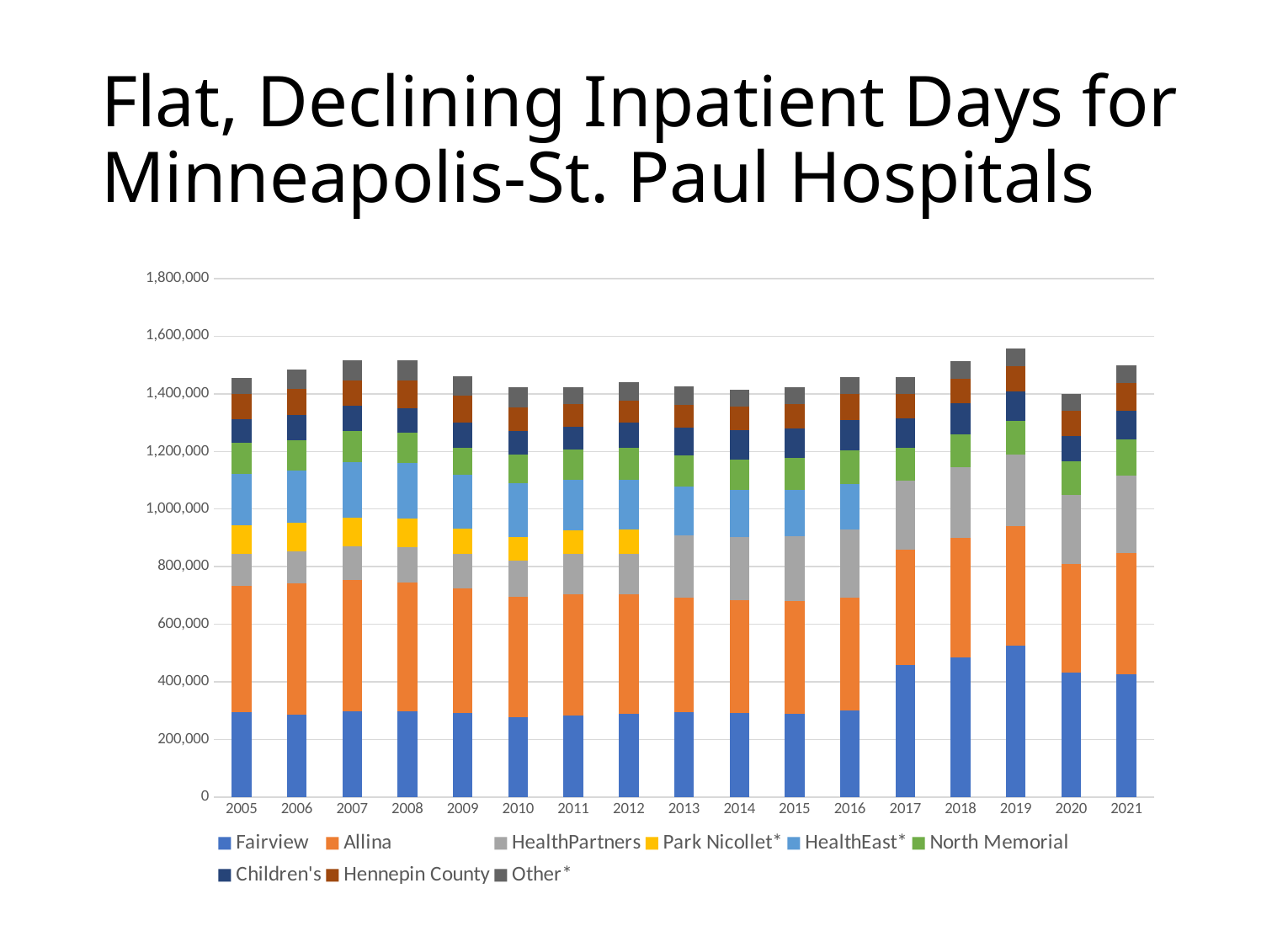
What kind of chart is shown on the slide? stacked bar chart What is the first year shown on the x axis of the chart? 2005 Is the Fairview segment for 2019 greater or less than 400,000? greater In which year does the Park Nicollet* segment last appear in the stacked bars? 2012 How many years are shown along the x axis of the chart? 17 Is the Fairview segment for 2005 greater or less than 400,000? less Which year has the larger total stacked bar, 2019 or 2020? 2019 Which year has the highest total inpatient days in the chart? 2019 How many series does the chart's legend list? 9 Which year has the larger Fairview segment, 2016 or 2017? 2017 Is the total stacked bar for 2019 greater or less than 1,400,000? greater